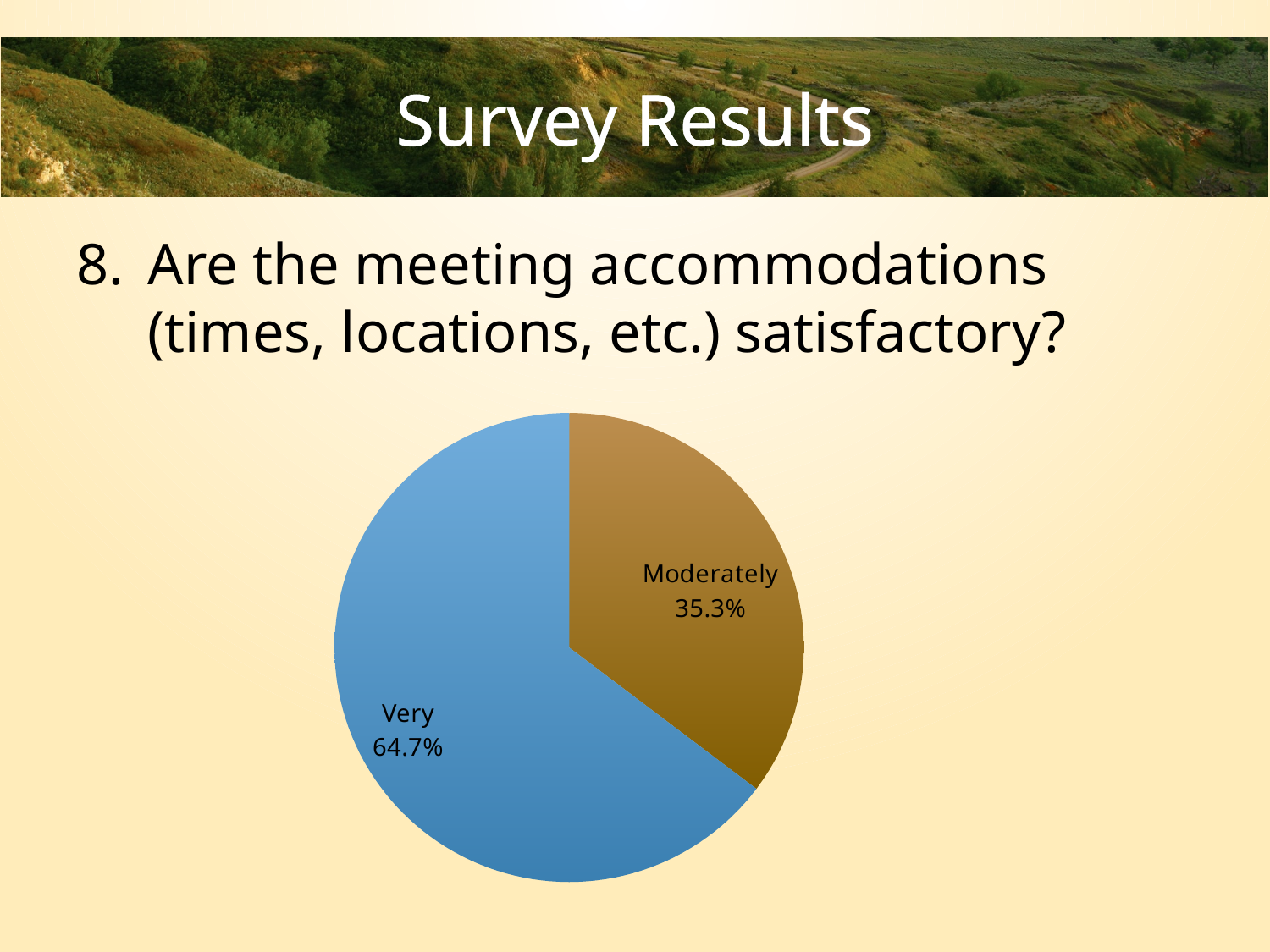
What is the difference in percentage points between the "Very" and "Moderately" slices? 29.4 percentage points What share of the pie is labelled "Very"? 64.7% Is the share for "Very" greater or less than 50%? greater Which is larger, the "Very" slice or the "Moderately" slice? Very What colour is the "Very" slice of the pie? blue How many slices does the pie chart have? 2 Which slice of the pie is the largest? Very Which slice of the pie is the smallest? Moderately What survey question does the pie chart on the slide illustrate? Are the meeting accommodations (times, locations, etc.) satisfactory? What type of chart is shown on the slide? pie chart What share of the pie is labelled "Moderately"? 35.3%